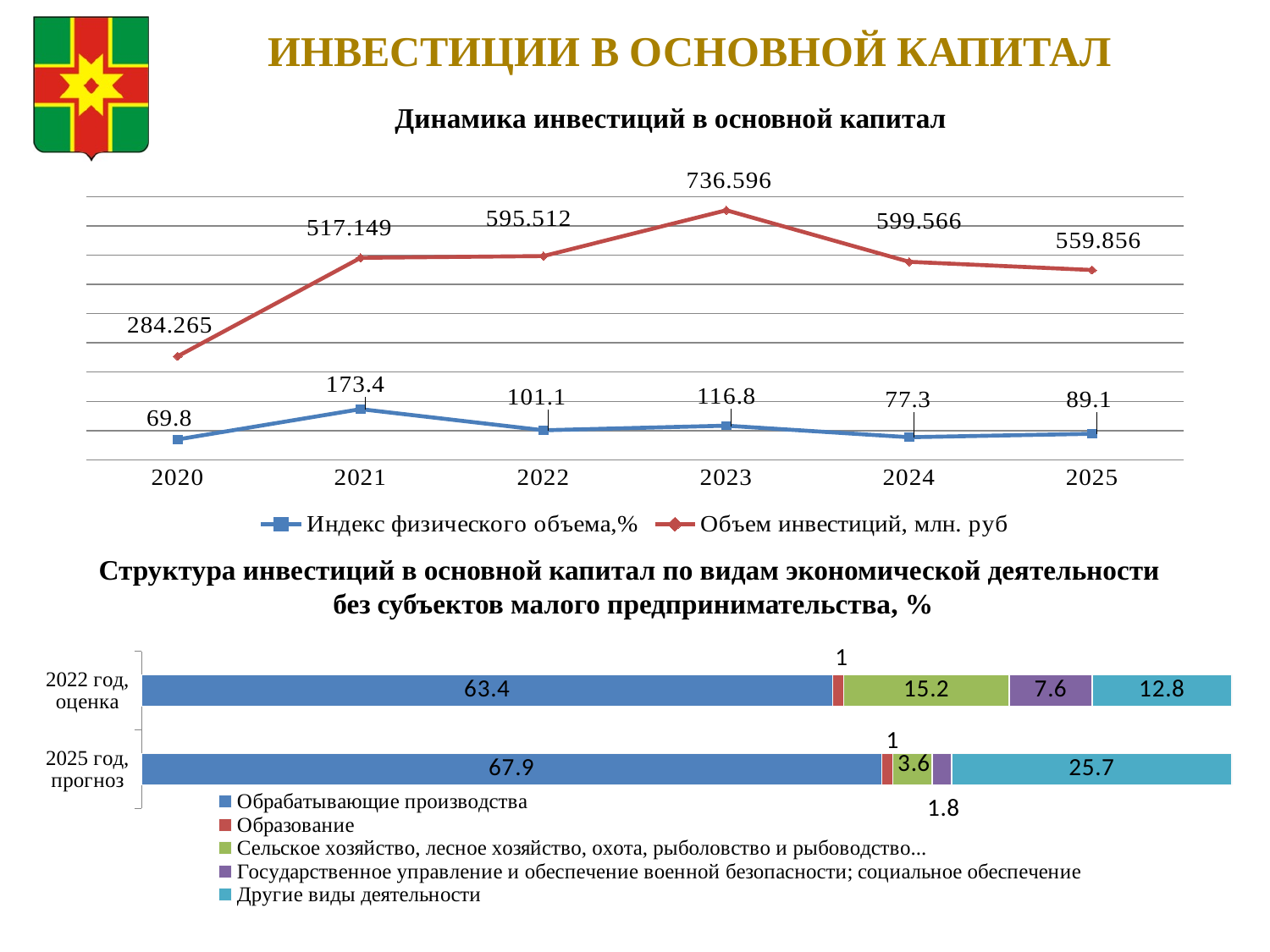
In the chart 'Динамика инвестиций в основной капитал', what is the difference between 'Объем инвестиций, млн. руб' in 2023 and in 2024? 137.03 In the chart 'Динамика инвестиций в основной капитал', how many series does the legend list? 2 In the chart 'Структура инвестиций в основной капитал по видам экономической деятельности', what is the total of the stacked bar for '2022 год, оценка'? 100 In the chart 'Структура инвестиций в основной капитал по видам экономической деятельности', what is the difference between 'Другие виды деятельности' for '2025 год, прогноз' and for '2022 год, оценка'? 12.9 In the chart 'Структура инвестиций в основной капитал по видам экономической деятельности', what is the share of 'Обрабатывающие производства' for '2025 год, прогноз'? 67.9 In the chart 'Динамика инвестиций в основной капитал', how many years are shown on the x axis? 6 In the chart 'Динамика инвестиций в основной капитал', which year has the lowest value of 'Объем инвестиций, млн. руб'? 2020 What kind of chart is 'Динамика инвестиций в основной капитал'? Line chart In the chart 'Динамика инвестиций в основной капитал', is 'Индекс физического объема,%' higher in 2022 or in 2024? 2022 In the chart 'Динамика инвестиций в основной капитал', what is the value of 'Индекс физического объема,%' for 2021? 173.4 In the chart 'Динамика инвестиций в основной капитал', which year has the highest value of 'Индекс физического объема,%'? 2021 In the chart 'Динамика инвестиций в основной капитал', what is the value of 'Объем инвестиций, млн. руб' for 2023? 736.596